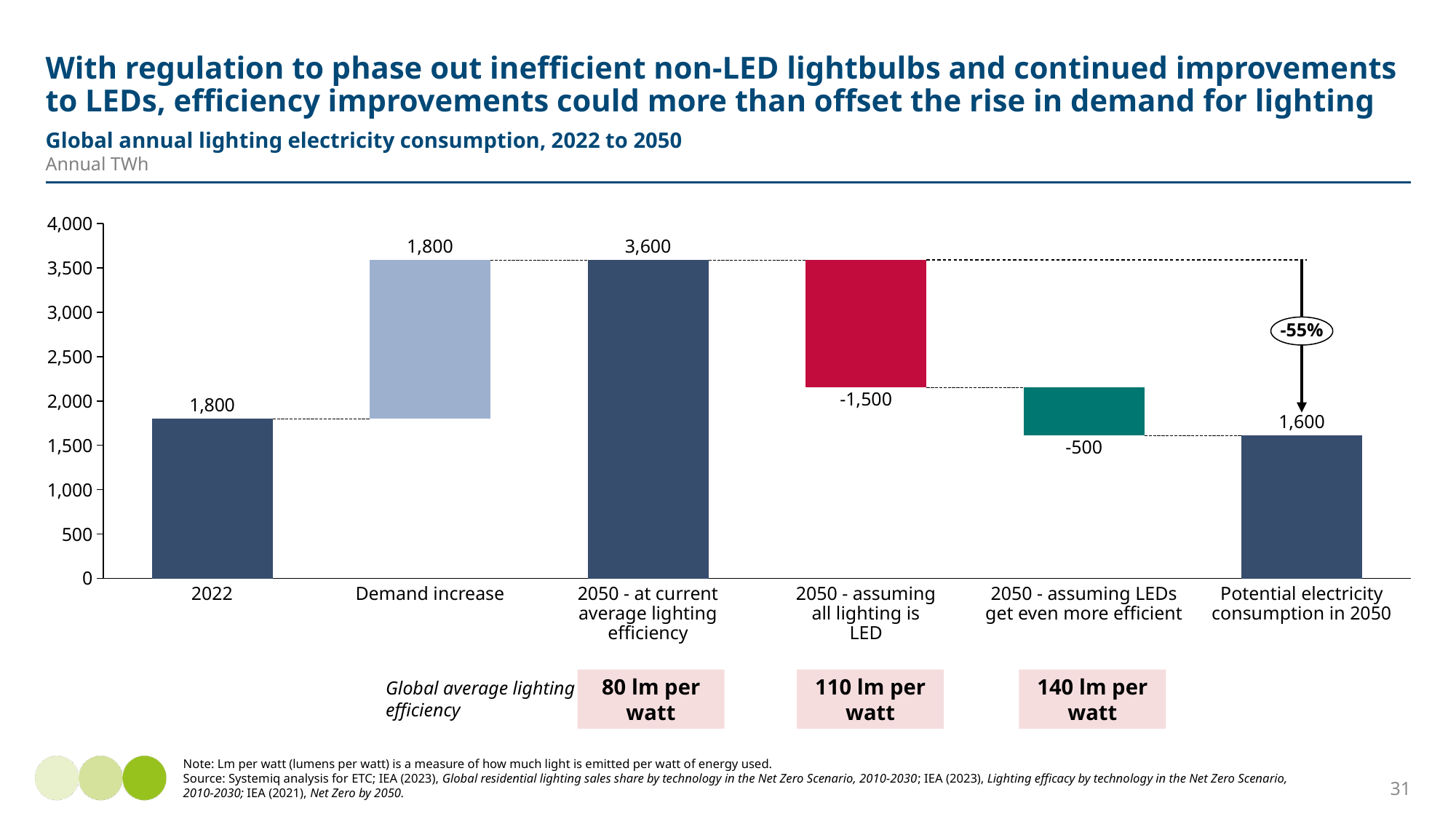
Which is larger: the value for 2022 or the value for 'Potential electricity consumption in 2050'? 2022 What is the value for '2050 - assuming all lighting is LED'? -1,500 What is the value for 'Demand increase'? 1,800 How many categories are shown on the x axis? 6 What is the value for 2022? 1,800 What kind of chart is this? Bar chart (waterfall) What is the value for '2050 - at current average lighting efficiency'? 3,600 What is the value for 'Potential electricity consumption in 2050'? 1,600 What percentage change is shown in the circled label next to the arrow? -55% What is the difference between the value for '2050 - at current average lighting efficiency' and the value for 'Potential electricity consumption in 2050'? 2,000 What is the value for '2050 - assuming LEDs get even more efficient'? -500 Which category has the highest value? 2050 - at current average lighting efficiency